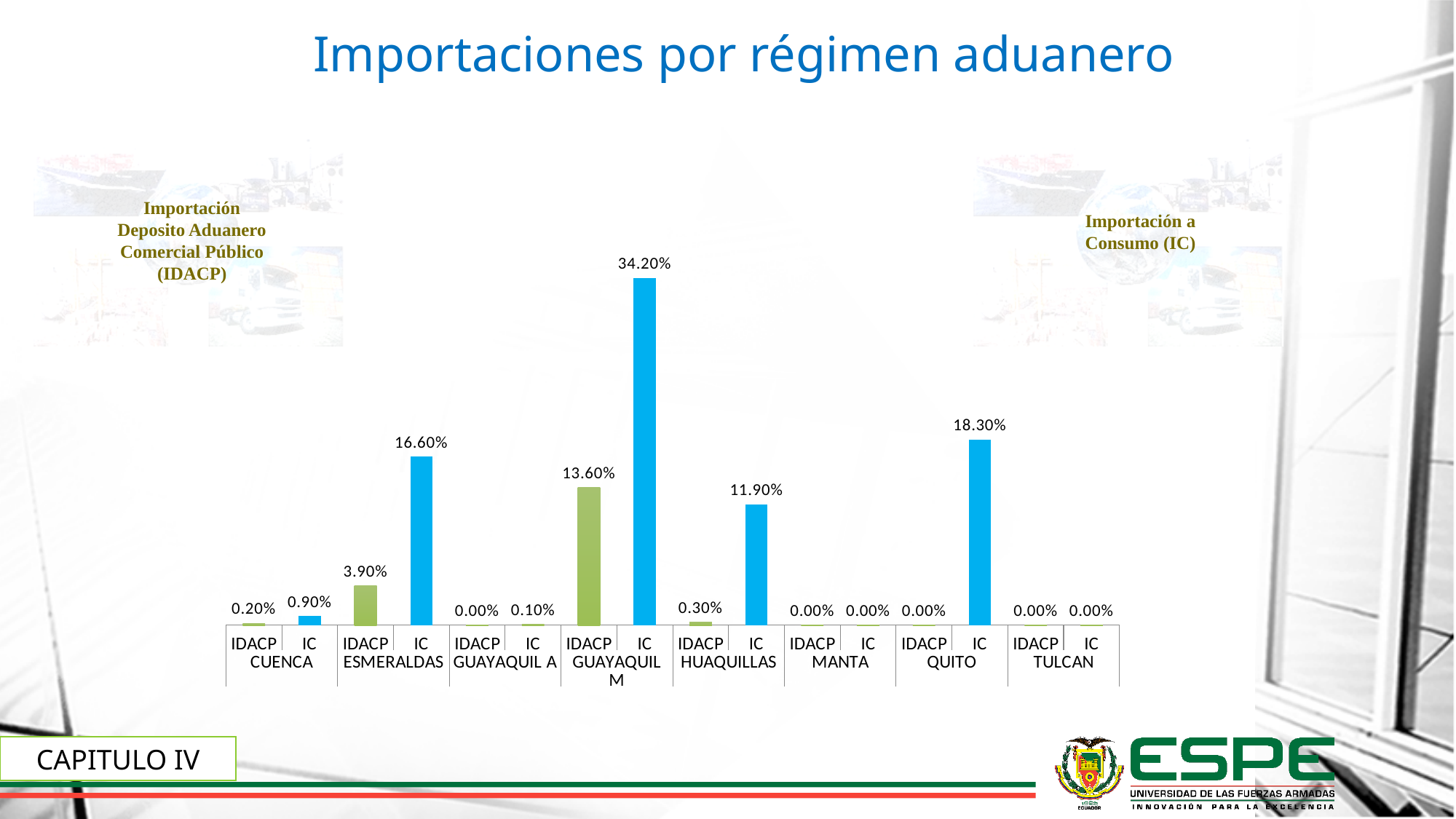
What is the value for IC in QUITO? 18.30% What is the value for IDACP in ESMERALDAS? 3.90% What is the value for IDACP in HUAQUILLAS? 0.30% What type of chart is shown on the slide? Bar chart How many customs districts (city groups) are shown on the x axis? 8 Which is larger, the IC value for QUITO or the IC value for ESMERALDAS? IC QUITO What is the title of the slide's chart? Importaciones por régimen aduanero Which bar has the highest value on the chart? IC GUAYAQUIL M Which is larger, the IDACP value for GUAYAQUIL M or the IC value for HUAQUILLAS? IDACP GUAYAQUIL M What is the difference between the IC and IDACP values for GUAYAQUIL M? 20.60% What is the value for IC in GUAYAQUIL M? 34.20% What is the difference between the IC value for ESMERALDAS and the IC value for HUAQUILLAS? 4.70%